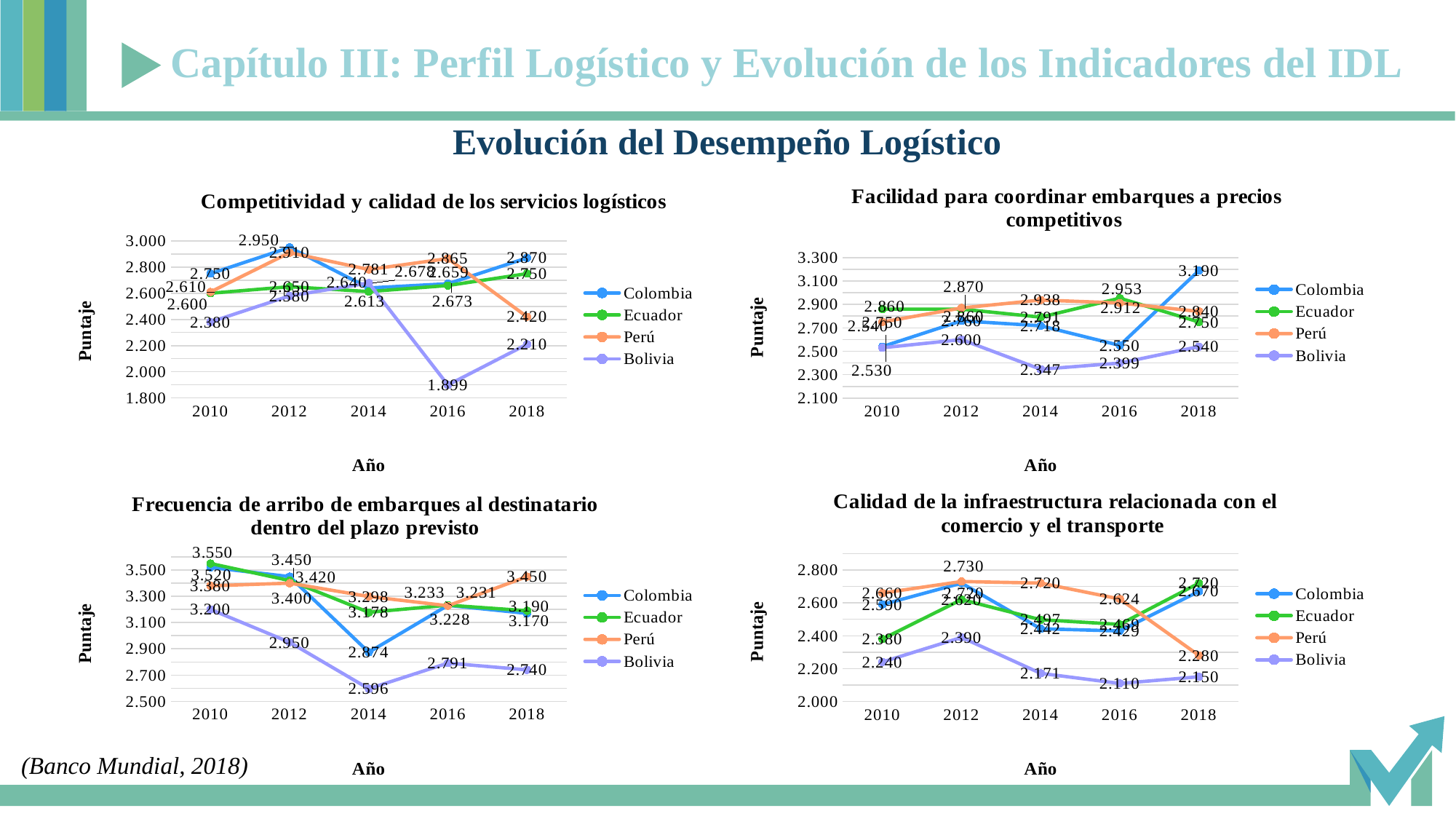
In the chart 'Calidad de la infraestructura relacionada con el comercio y el transporte', is the value for Bolivia in 2016 greater or less than 2.200? less In the chart 'Frecuencia de arribo de embarques al destinatario dentro del plazo previsto', what is the value for Bolivia in 2014? 2.596 In the chart 'Facilidad para coordinar embarques a precios competitivos', how many series does the legend list? 4 In the chart 'Facilidad para coordinar embarques a precios competitivos', what is the value for Bolivia in 2014? 2.347 In the chart 'Frecuencia de arribo de embarques al destinatario dentro del plazo previsto', which country has the highest value in 2018? Perú In the chart 'Frecuencia de arribo de embarques al destinatario dentro del plazo previsto', what is the difference between Bolivia's values in 2016 and 2014? 0.195 In the chart 'Competitividad y calidad de los servicios logísticos', which country has the lowest value in 2018? Bolivia In the chart 'Competitividad y calidad de los servicios logísticos', what is the value for Colombia in 2012? 2.950 In the chart 'Facilidad para coordinar embarques a precios competitivos', what is the value for Colombia in 2018? 3.190 In the chart 'Calidad de la infraestructura relacionada con el comercio y el transporte', what is the value for Perú in 2018? 2.280 What kind of chart is 'Calidad de la infraestructura relacionada con el comercio y el transporte'? Line chart In the chart 'Competitividad y calidad de los servicios logísticos', what is the value for Bolivia in 2016? 1.899